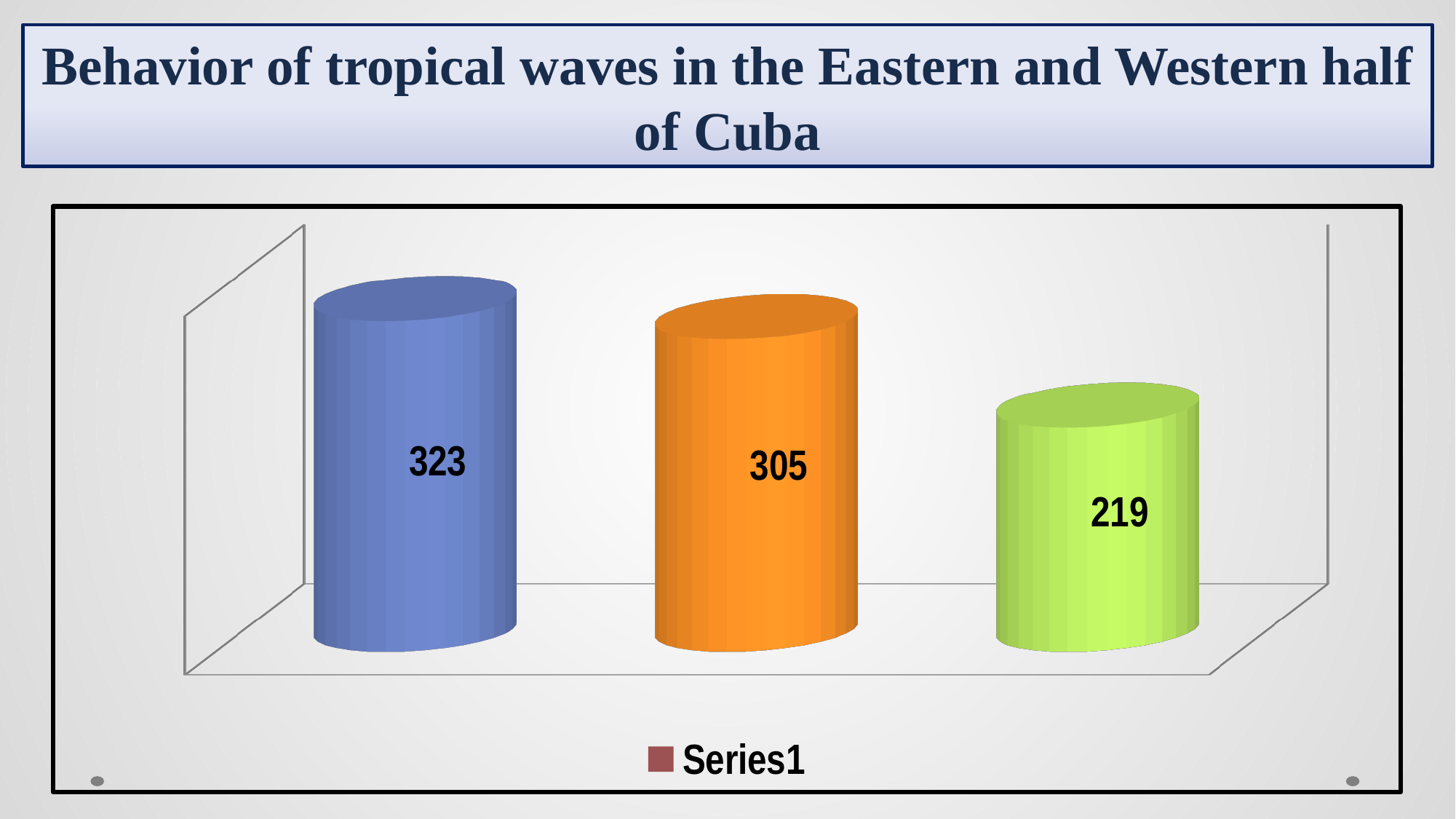
What kind of chart is shown on the slide? Bar chart What value is shown on the green bar (the rightmost bar)? 219 Which is larger, the value of the orange bar or the value of the green bar? The orange bar (305) Which bar has the lowest value? The green (rightmost) bar, 219 What value is shown on the orange bar (the middle bar)? 305 What is the difference between the values of the orange bar and the green bar? 86 How many series does the legend list? 1 Do the bar values rise or fall from left to right? Fall Which bar has the highest value? The blue (leftmost) bar, 323 What is the difference between the values of the blue bar and the orange bar? 18 How many bars are plotted in the chart? 3 What value is shown on the blue bar (the leftmost bar)? 323